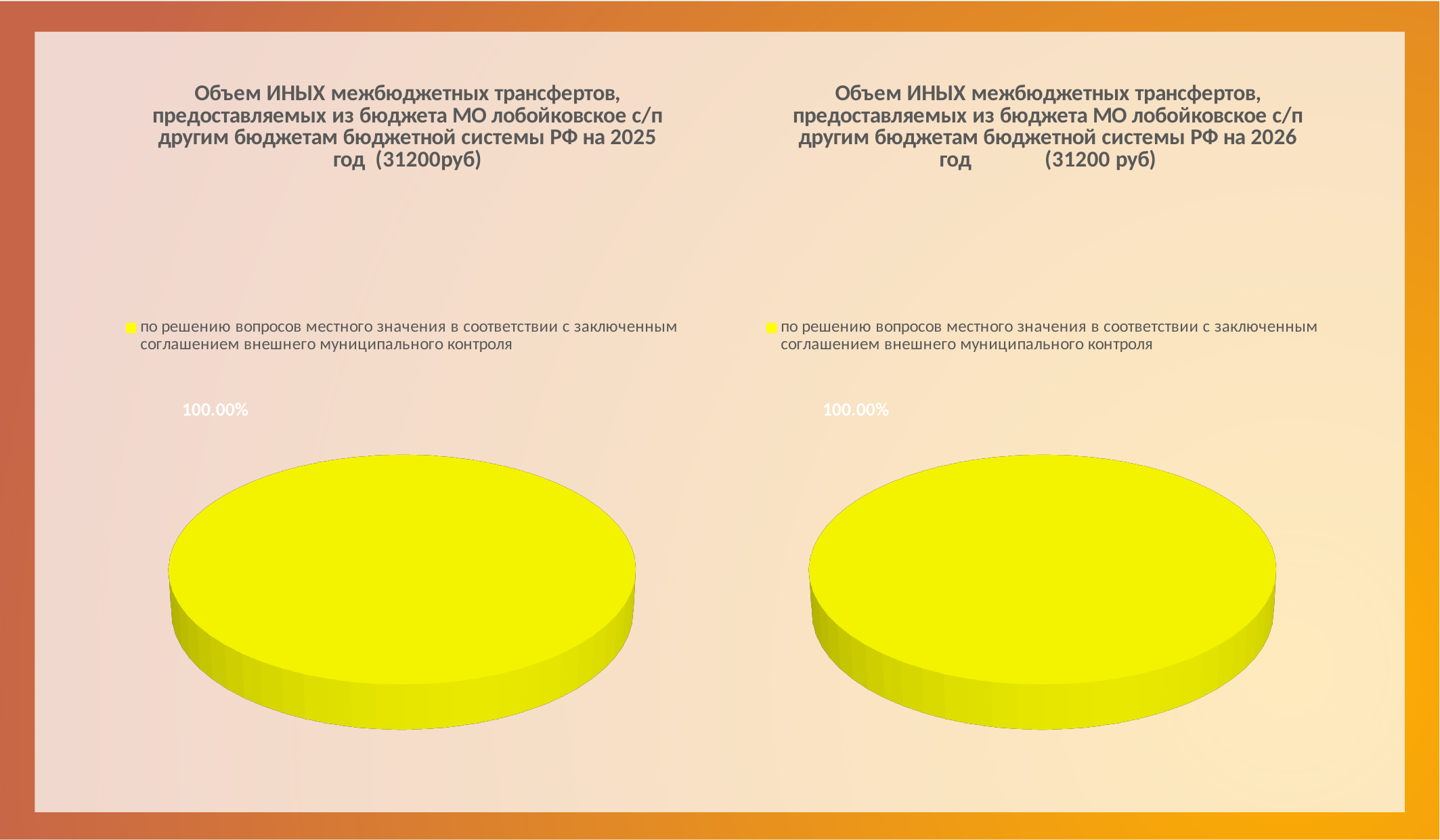
What data label is printed on the right chart (for 2026)? 100.00% How many slices does the right chart (for 2026) have? 1 How many slices does the left chart (for 2025) have? 1 How many entries does the legend of the left chart (for 2025) list? 1 What kind of chart is the left chart (for 2025)? pie chart In the left chart (for 2025), what share of the pie does the slice 'по решению вопросов местного значения в соответствии с заключенным соглашением внешнего муниципального контроля' take? 100.00% What total amount in rubles is stated in the title of the right chart (for 2026)? 31200 руб What data label is printed on the left chart (for 2025)? 100.00% What kind of chart is the right chart (for 2026)? pie chart What colour is the single slice in the left chart (for 2025)? yellow In the right chart (for 2026), what share of the pie does the slice 'по решению вопросов местного значения в соответствии с заключенным соглашением внешнего муниципального контроля' take? 100.00% How many entries does the legend of the right chart (for 2026) list? 1